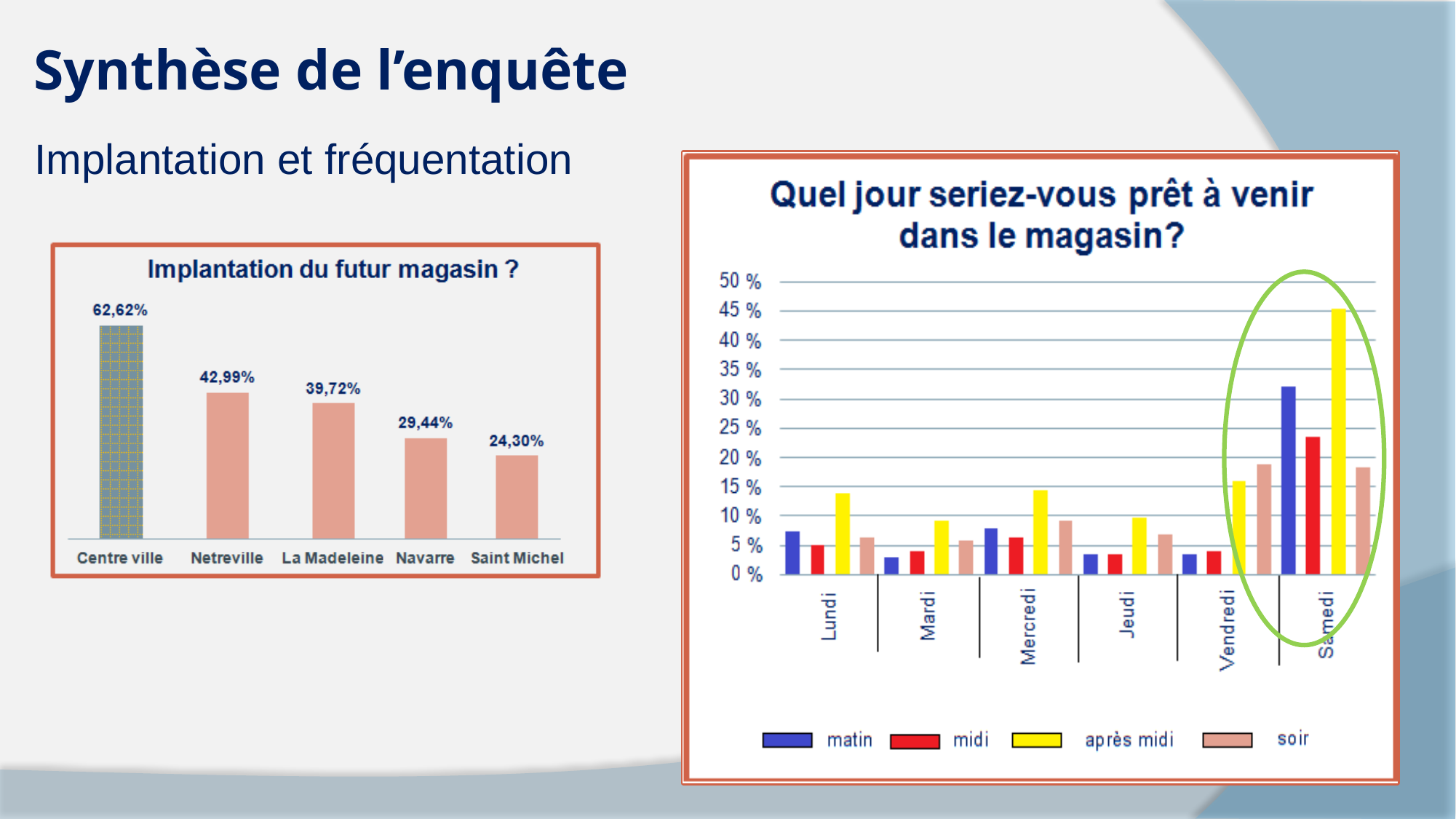
In the chart 'Quel jour seriez-vous prêt à venir dans le magasin?', how many days are shown on the x axis? 6 In the chart 'Implantation du futur magasin ?', which location has the lowest value? Saint Michel In the chart 'Quel jour seriez-vous prêt à venir dans le magasin?', which colour represents 'soir' in the legend? Light pink/salmon In the chart 'Implantation du futur magasin ?', what is the value for Navarre? 29,44% In the chart 'Implantation du futur magasin ?', what is the value for Centre ville? 62,62% In the chart 'Implantation du futur magasin ?', how many locations are shown? 5 In the chart 'Quel jour seriez-vous prêt à venir dans le magasin?', is the 'après midi' value for Samedi greater or less than 40 %? greater In the chart 'Implantation du futur magasin ?', which is larger: Navarre or Saint Michel? Navarre In the chart 'Implantation du futur magasin ?', what is the difference between Netreville and La Madeleine? 3,27% In the chart 'Quel jour seriez-vous prêt à venir dans le magasin?', how many series does the legend list? 4 In the chart 'Quel jour seriez-vous prêt à venir dans le magasin?', which day has the highest 'après midi' bar? Samedi In the chart 'Quel jour seriez-vous prêt à venir dans le magasin?', is the 'matin' value for Samedi greater or less than 25 %? greater